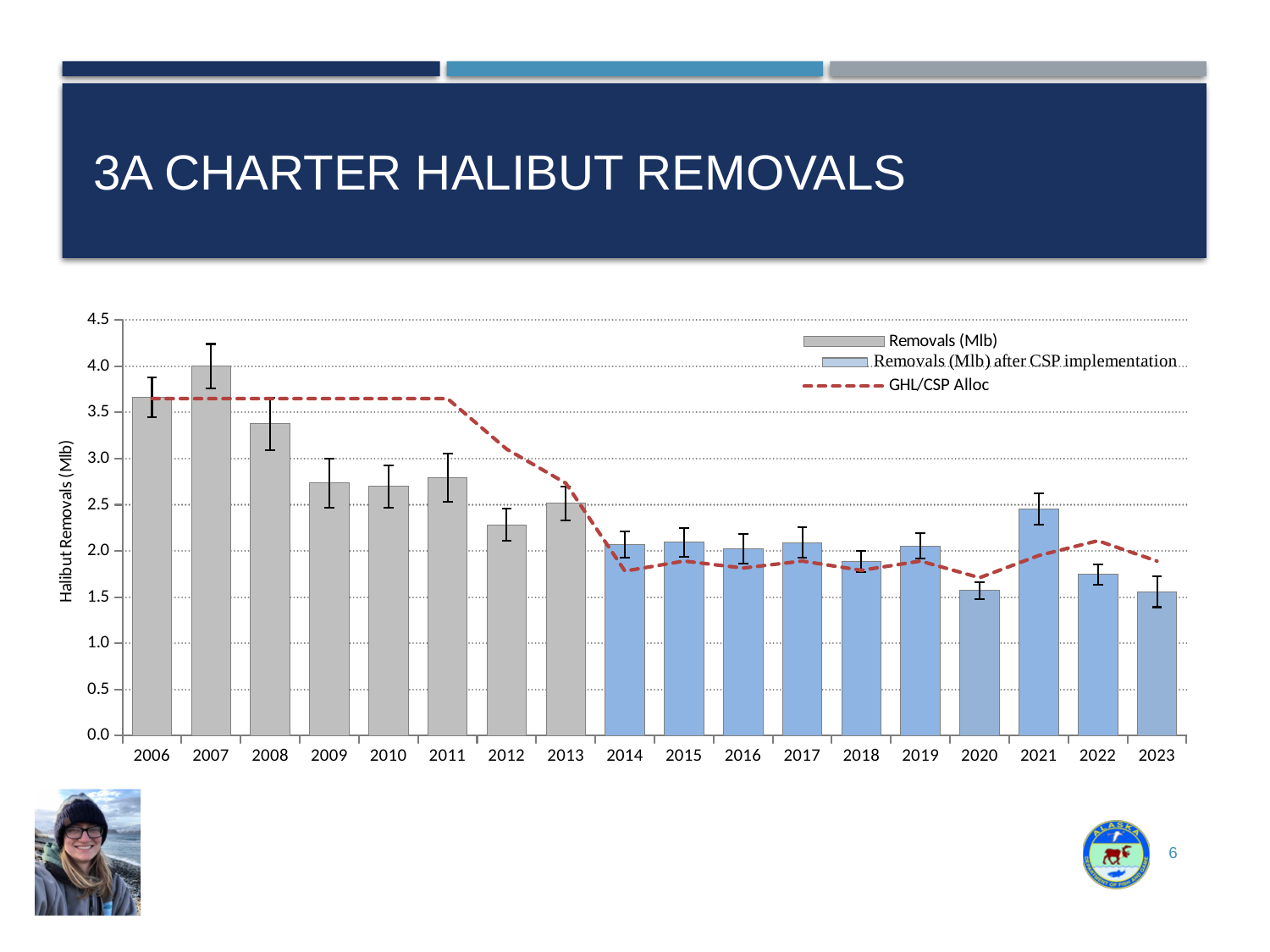
What is the legend label for the red dashed line? GHL/CSP Alloc Which year has the larger removals value, 2006 or 2008? 2006 How many series does the chart's legend list? 3 Among the gray 'Removals (Mlb)' bars (2006–2013), which year has the lowest value? 2012 Is the removals value for 2006 greater or less than 3.5? greater Is the removals value for 2012 greater or less than 2.5? less Which year has the larger removals value, 2021 or 2022? 2021 What kind of chart is shown on the slide? bar and line chart How many years are shown along the x axis of the chart? 18 Do the gray removals bars generally rise or fall from 2006 to 2013? fall Which year has the highest halibut removals bar? 2007 Is the removals value for 2020 greater or less than 2.0? less